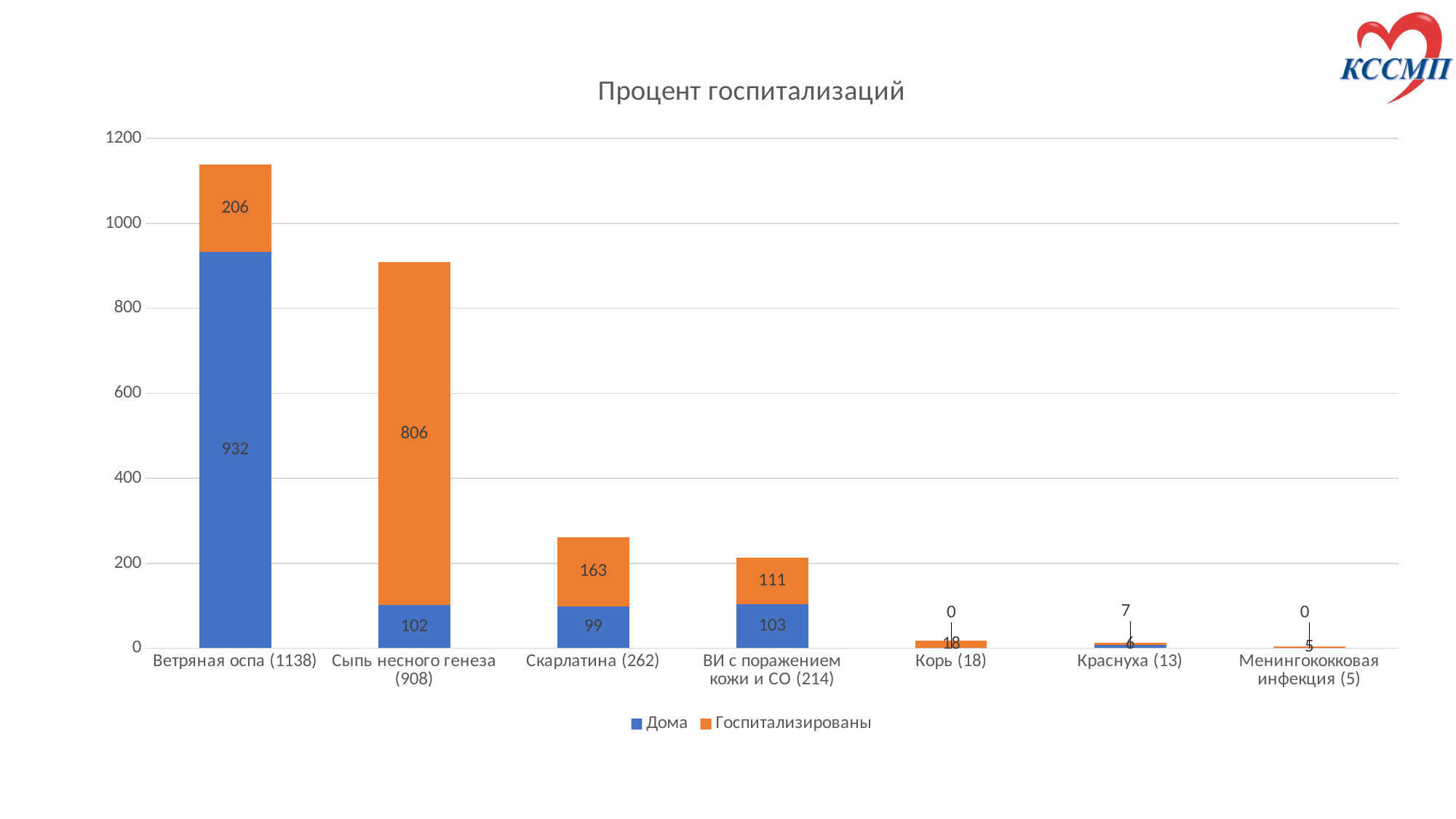
What is the title of the chart? Процент госпитализаций What type of chart is shown on the slide? stacked bar chart Which category has the highest value for Дома? Ветряная оспа (1138) How many categories are shown on the x axis? 7 How many series does the legend list? 2 What is the value of Дома for Ветряная оспа (1138)? 932 What is the value of Госпитализированы for Скарлатина (262)? 163 Which is larger for Скарлатина (262): Дома or Госпитализированы? Госпитализированы What is the difference between Госпитализированы and Дома for ВИ с поражением кожи и СО (214)? 8 What is the value of Госпитализированы for Сыпь несного генеза (908)? 806 What is the total of the stacked bar for Ветряная оспа (1138)? 1138 Which category has the highest value for Госпитализированы? Сыпь несного генеза (908)